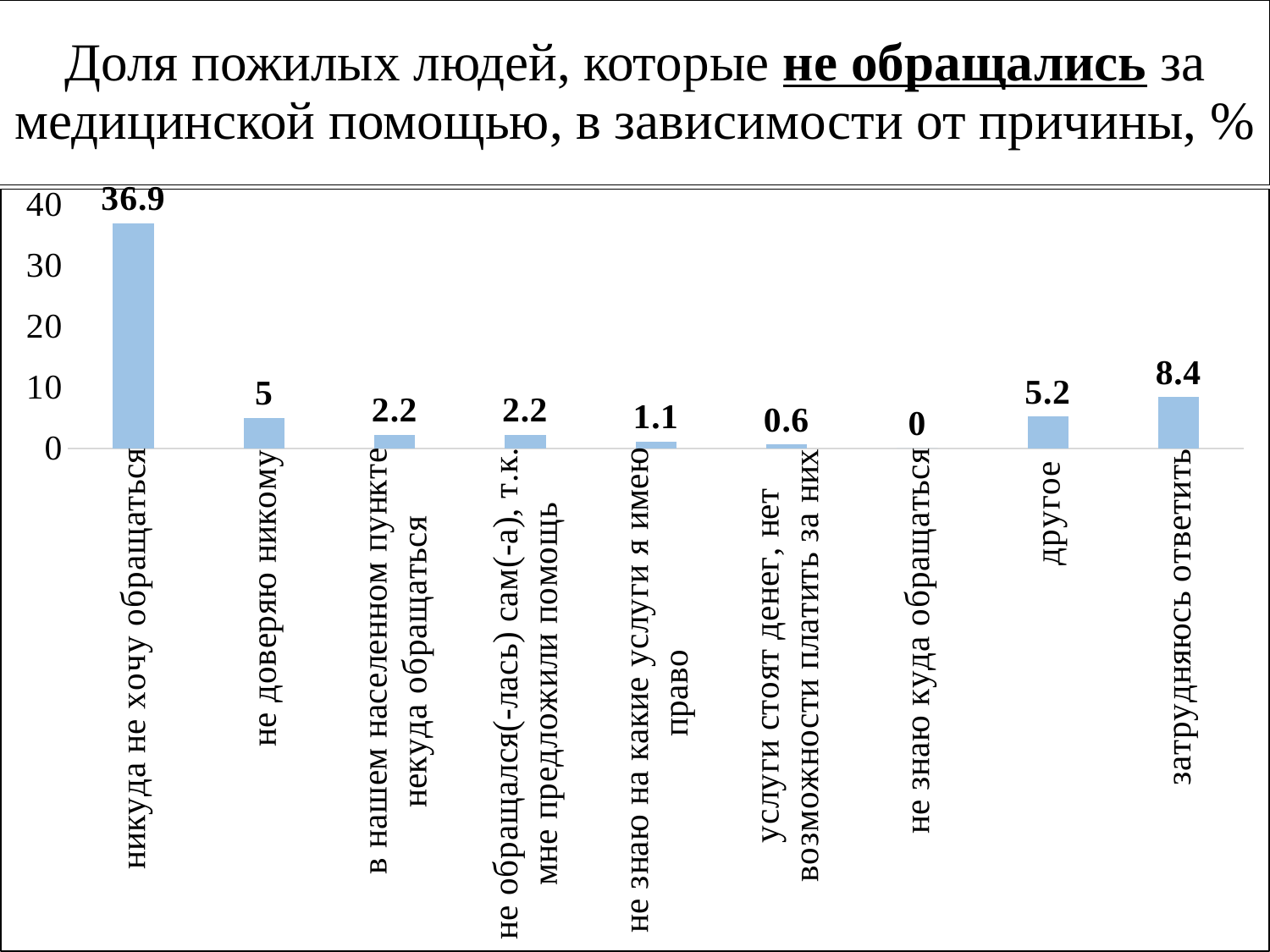
What kind of chart is shown on the slide? bar chart Which category has the lowest value? не знаю куда обращаться What is the value for "не знаю на какие услуги я имею право"? 1.1 Which category has the highest value? никуда не хочу обращаться What is the value for "не доверяю никому"? 5 How many categories are shown on the chart? 9 What is the value for "затрудняюсь ответить"? 8.4 What is the value for "услуги стоят денег, нет возможности платить за них"? 0.6 Which is larger, the value for "не доверяю никому" or the value for "другое"? другое Is the value for "никуда не хочу обращаться" greater or less than 30? greater What is the value for "никуда не хочу обращаться"? 36.9 What is the difference between the values for "затрудняюсь ответить" and "другое"? 3.2